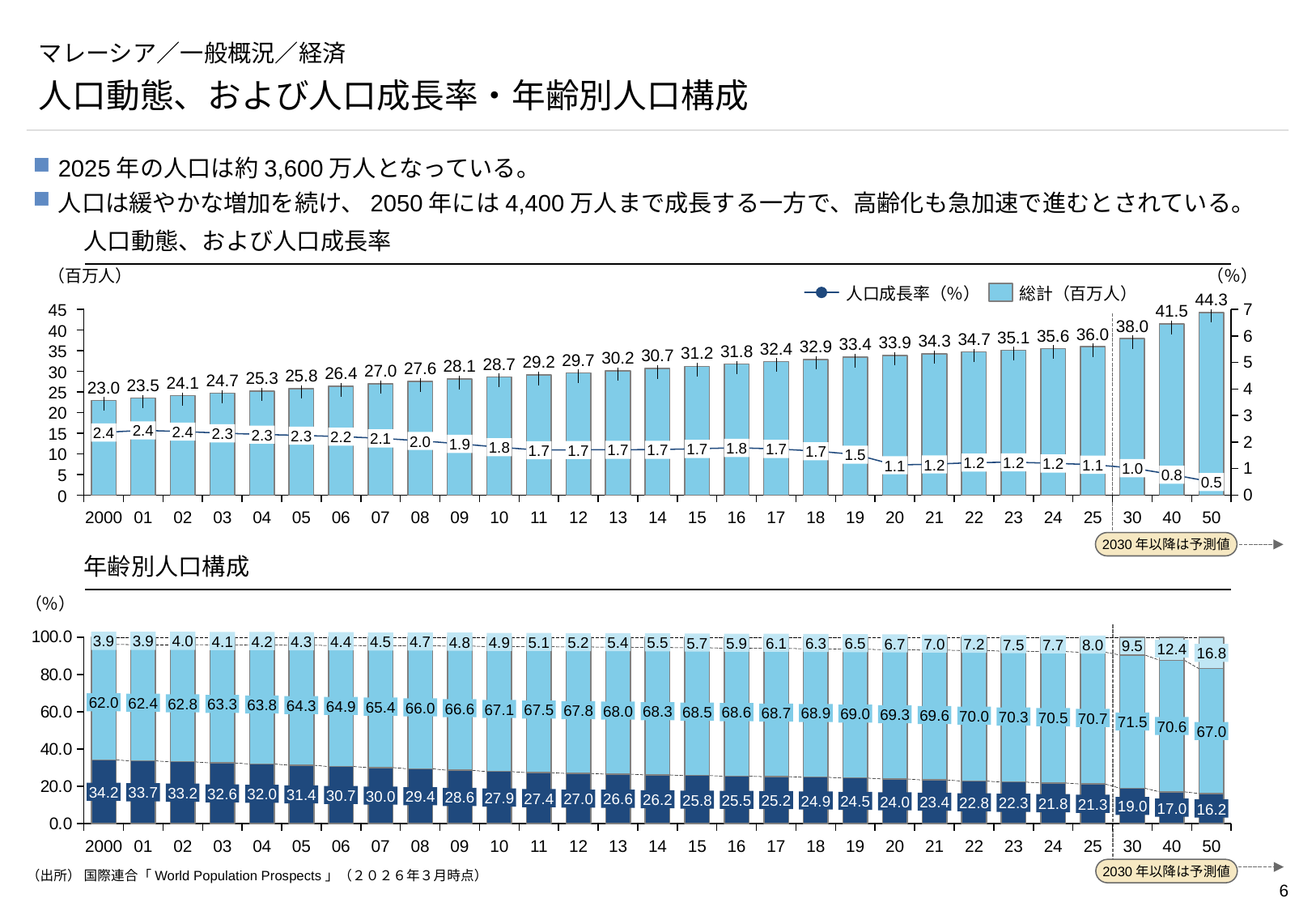
In the top chart (人口動態、および人口成長率), does the total population rise or fall from 2000 to 2050? rise In the top chart (人口動態、および人口成長率), what is the population growth rate (人口成長率) for 2050? 0.5 In the top chart (人口動態、および人口成長率), which year has the highest total population? 2050 (44.3) In the top chart (人口動態、および人口成長率), what is the difference between the total population in 2050 and in 2000? 21.3 In the top chart (人口動態、および人口成長率), which year has the lowest population growth rate? 2050 (0.5) In the bottom chart (年齢別人口構成), does the dark blue bottom segment rise or fall from 2000 to 2050? fall What kind of chart is the bottom chart (年齢別人口構成)? stacked bar chart In the top chart (人口動態、および人口成長率), what is the total population (総計) for 2000? 23.0 In the bottom chart (年齢別人口構成), what is the value of the top segment for 2050? 16.8 In the top chart (人口動態、および人口成長率), how many series does the legend list? 2 In the top chart (人口動態、および人口成長率), is the population growth rate higher in 2000 or in 2025? 2000 In the bottom chart (年齢別人口構成), what is the value of the dark blue bottom segment for 2000? 34.2